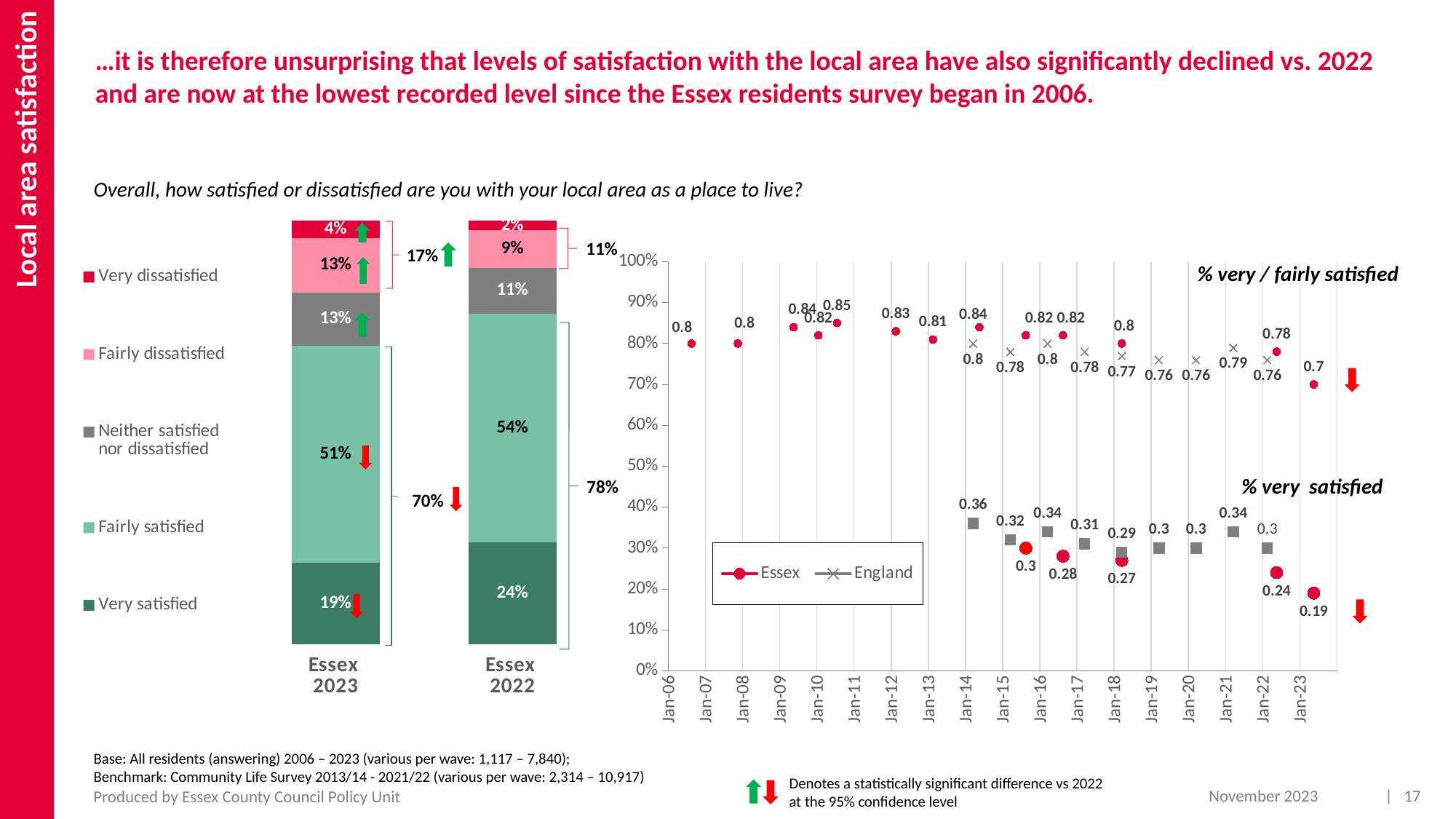
In the right-hand time series chart, at which date is the Essex % very / fairly satisfied value lowest? Jan-23 In the stacked bar chart, what is the combined very/fairly satisfied share for Essex 2023? 70% In the stacked bar chart, what percentage of Essex 2022 respondents were fairly satisfied? 54% What kind of chart is the left-hand chart showing Essex 2023 and Essex 2022? Stacked bar chart In the right-hand time series chart, what is the Essex % very / fairly satisfied value at Jan-23? 0.7 In the stacked bar chart, which year has the larger fairly dissatisfied share, Essex 2023 or Essex 2022? Essex 2023 In the right-hand time series chart, what is the England % very satisfied value at Jan-14? 0.36 In the stacked bar chart, by how many percentage points did the very satisfied share fall from Essex 2022 to Essex 2023? 5 percentage points In the stacked bar chart, what percentage of Essex 2022 respondents were neither satisfied nor dissatisfied? 11% In the right-hand time series chart, how many series does the legend list? 2 In the stacked bar chart, what percentage of Essex 2023 respondents were very satisfied? 19% In the right-hand time series chart, what is the Essex % very satisfied value at Jan-23? 0.19